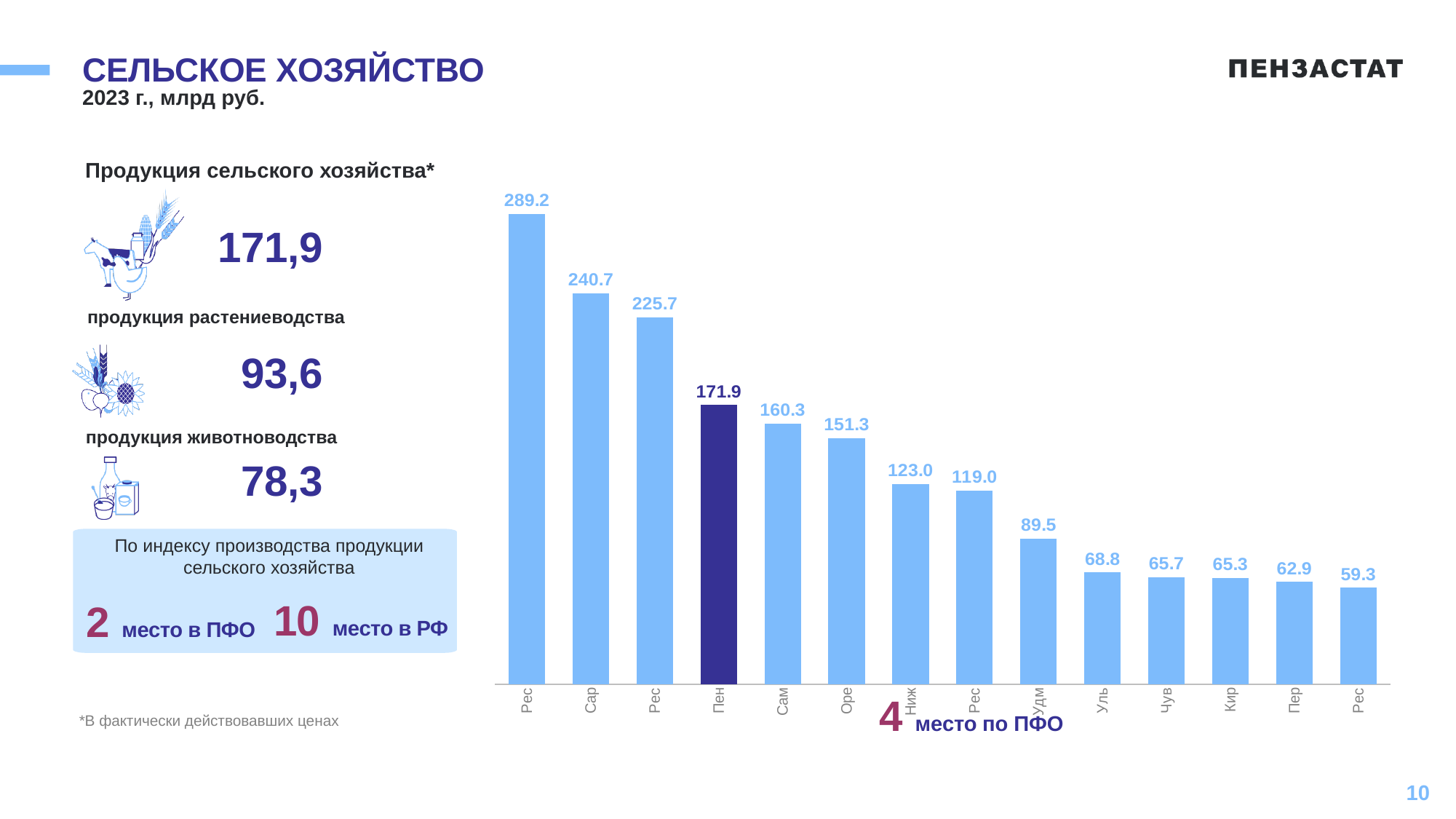
What is the value of the bar labelled "Сар" in the bar chart? 240.7 What is the difference between the bars labelled "Пен" and "Сам" in the bar chart? 11.6 What is the value of the bar labelled "Ниж" in the bar chart? 123.0 What is the value of the dark blue bar labelled "Пен" in the bar chart? 171.9 How many bars are shown in the bar chart? 14 Which bar is larger in the bar chart: "Оре" or "Уль"? Оре What is the lowest value shown in the bar chart? 59.3 What is the value of the bar labelled "Удм" in the bar chart? 89.5 Do the values in the bar chart rise or fall from left to right? fall What is the highest value shown in the bar chart? 289.2 What is the difference between the highest bar (289.2) and the bar labelled "Пен" in the bar chart? 117.3 What is the value of the bar labelled "Сам" in the bar chart? 160.3